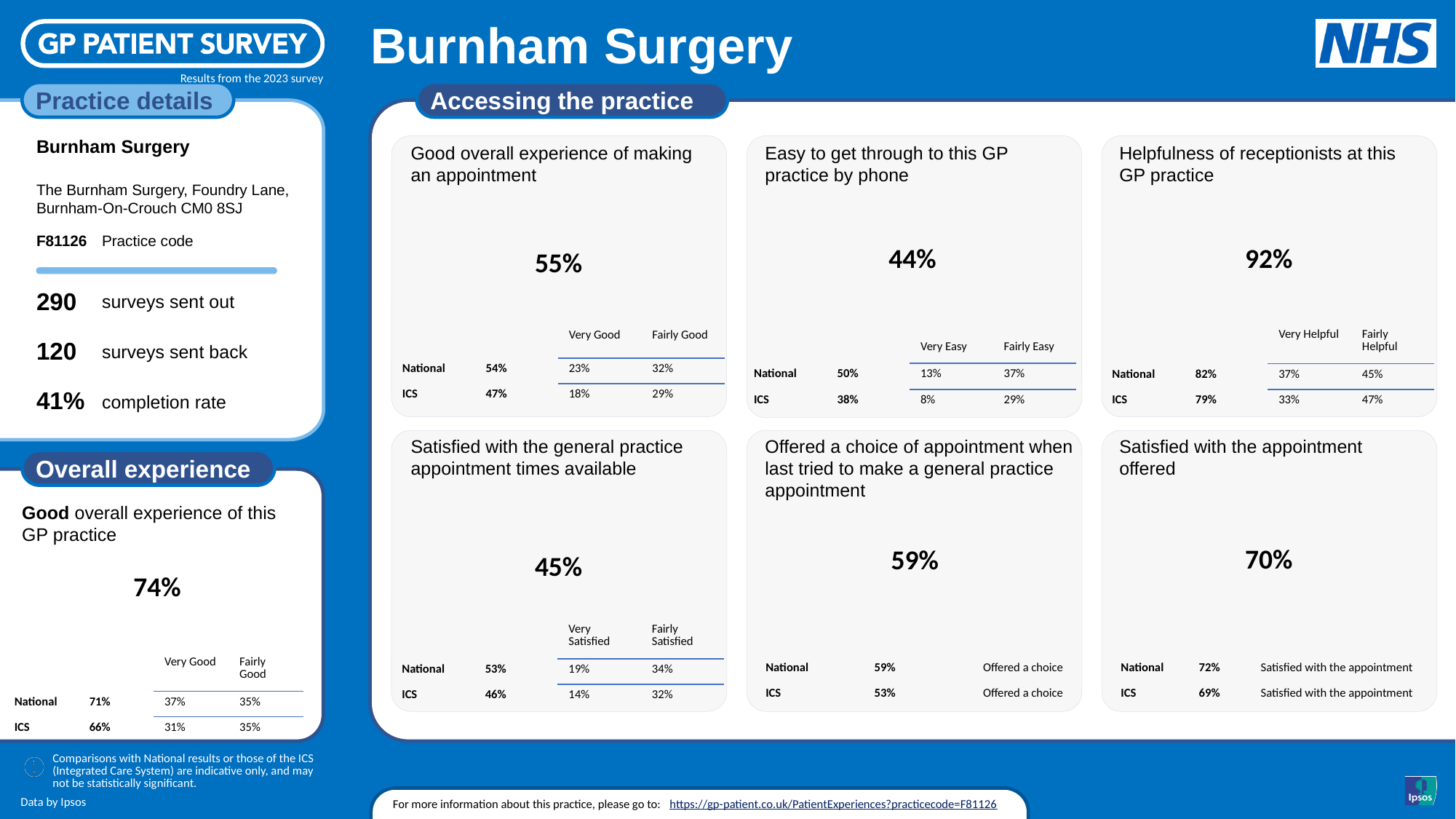
Across the six 'Accessing the practice' panels, which measure has the lowest practice percentage? Easy to get through to this GP practice by phone In the 'Easy to get through to this GP practice by phone' panel, what are the two response categories listed in the table? Very Easy and Fairly Easy In the 'Satisfied with the general practice appointment times available' panel, what is the difference between the National value and the ICS value? 7% In the 'Overall experience' panel, what is the practice's percentage for good overall experience of this GP practice? 74% In the 'Overall experience' panel, what is the difference between the National 'Very Good' and ICS 'Very Good' percentages? 6% In the 'Satisfied with the appointment offered' panel, what is the ICS value? 69% In the 'Offered a choice of appointment' panel, is the practice value larger than the ICS value? Yes, 59% vs 53% In the 'Easy to get through to this GP practice by phone' panel, what is the National value? 50% In the 'Good overall experience of making an appointment' panel, what is the practice's headline percentage? 55% How many measure panels are shown under the 'Accessing the practice' heading? 6 In the 'Helpfulness of receptionists at this GP practice' panel, what is the ICS 'Fairly Helpful' percentage? 47% Across the six 'Accessing the practice' panels, which measure has the highest practice percentage? Helpfulness of receptionists at this GP practice